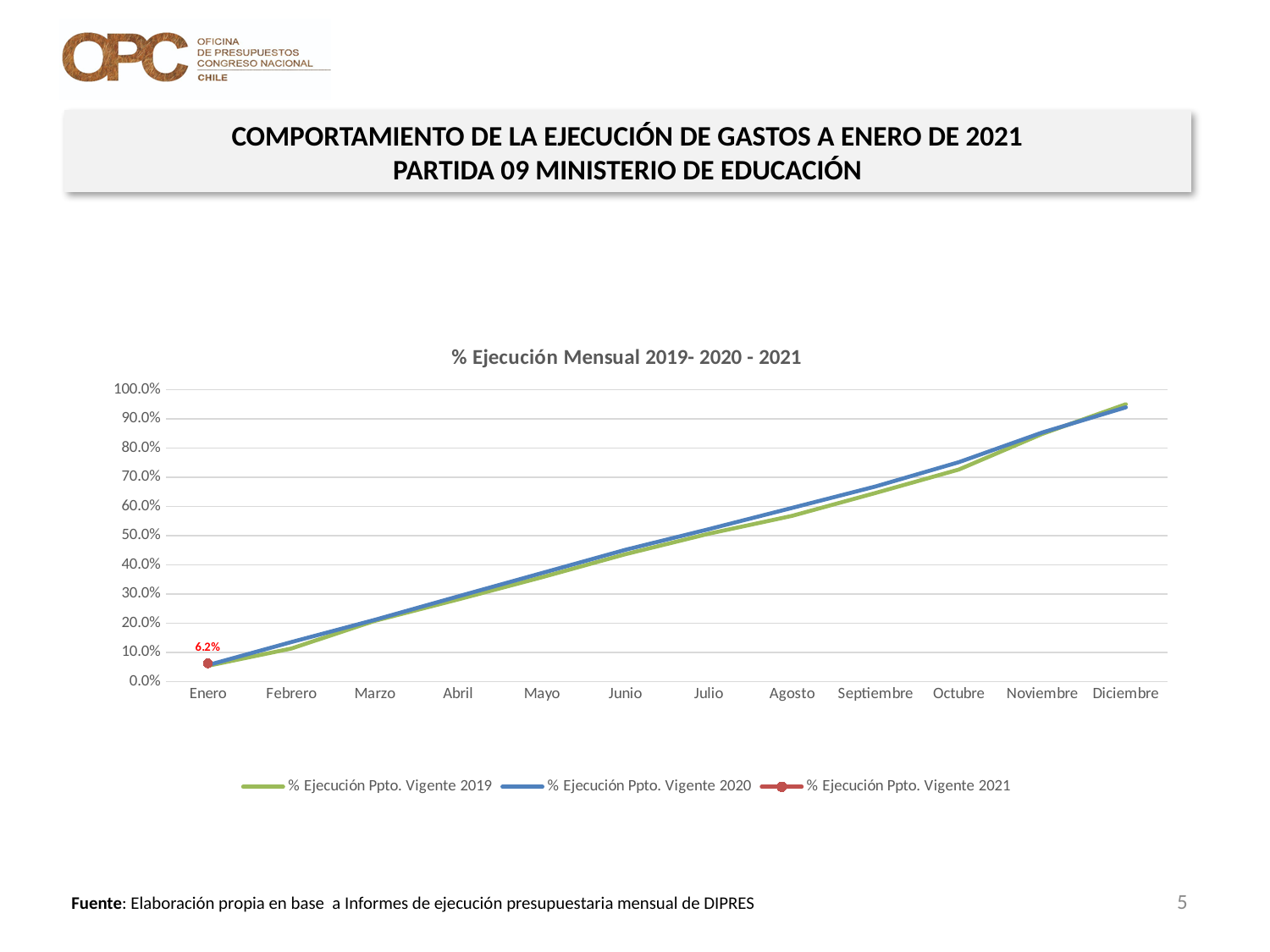
Is the value for Marzo in the % Ejecución Ppto. Vigente 2019 series greater or less than 30%? less Is the value for Junio in the % Ejecución Ppto. Vigente 2020 series greater or less than 50%? less Which month has the lowest value in the % Ejecución Ppto. Vigente 2019 series? Enero Is the value for Enero in the % Ejecución Ppto. Vigente 2019 series greater or less than 10%? less What is the value for Enero in the series % Ejecución Ppto. Vigente 2021? 6.2% What kind of chart is shown on the slide? line chart Do the values of the % Ejecución Ppto. Vigente 2020 series rise or fall from Enero to Diciembre? rise Which month has the highest value in the % Ejecución Ppto. Vigente 2020 series? Diciembre What is the title of the chart? % Ejecución Mensual 2019- 2020 - 2021 How many series does the legend of the chart list? 3 How many months are shown along the x axis of the chart? 12